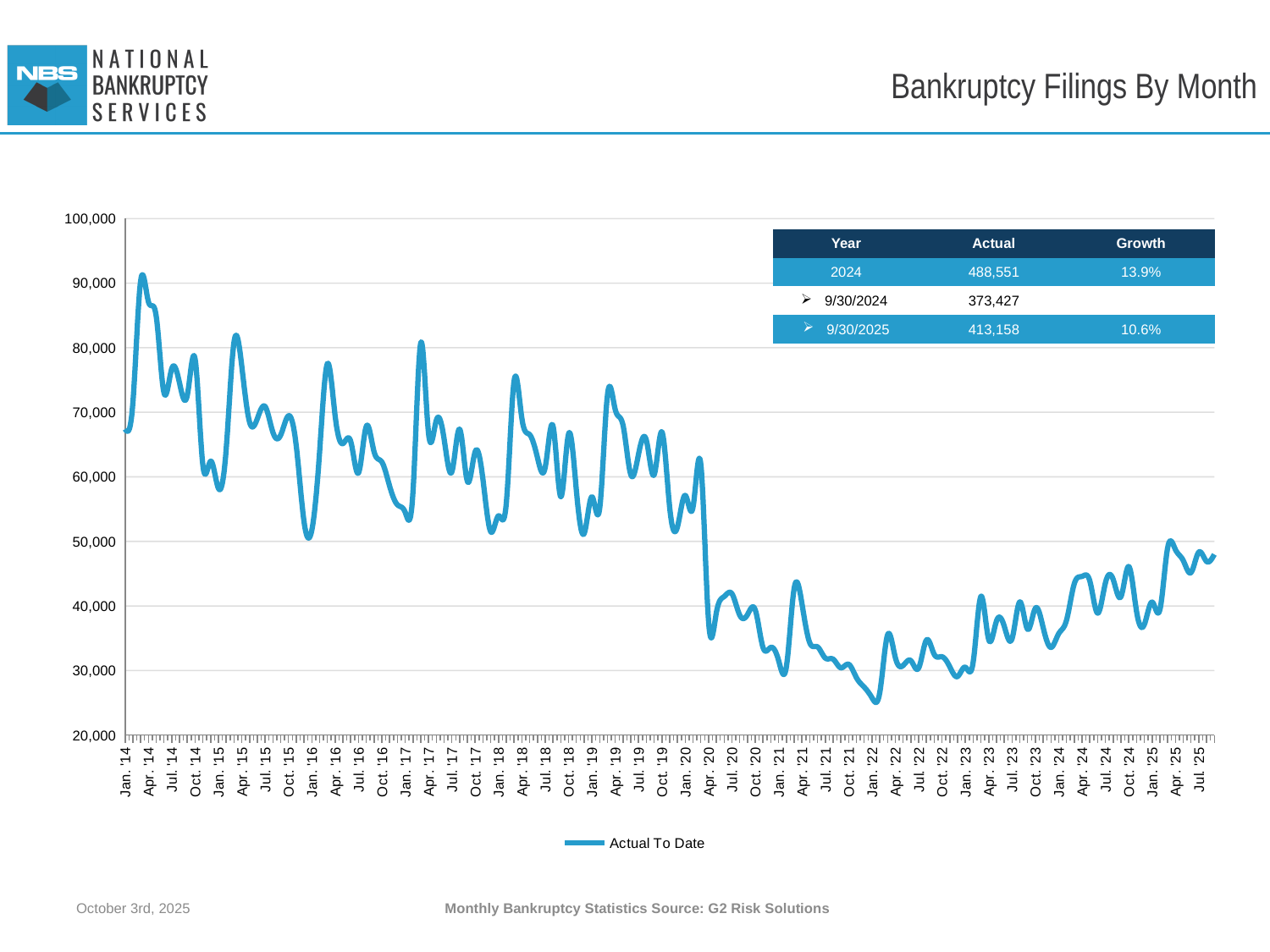
Is the value for Jan. '14 greater or less than 60,000? greater In which year does the line reach its highest value? 2014 What is the title of the chart? Bankruptcy Filings By Month How many series does the legend list? 1 According to the table on the chart, what is the difference between the Actual values for 9/30/2025 and 9/30/2024? 39,731 According to the table on the chart, what is the Actual value for 2024? 488,551 In which year does the line reach its lowest value? 2022 What kind of chart is shown on the slide? line chart Do the values generally rise or fall from Jan. '14 to Jan. '22? fall What is the name of the series shown in the legend? Actual To Date Is the value for Jan. '22 greater or less than 30,000? less Is the value for Jul. '25 greater or less than 40,000? greater